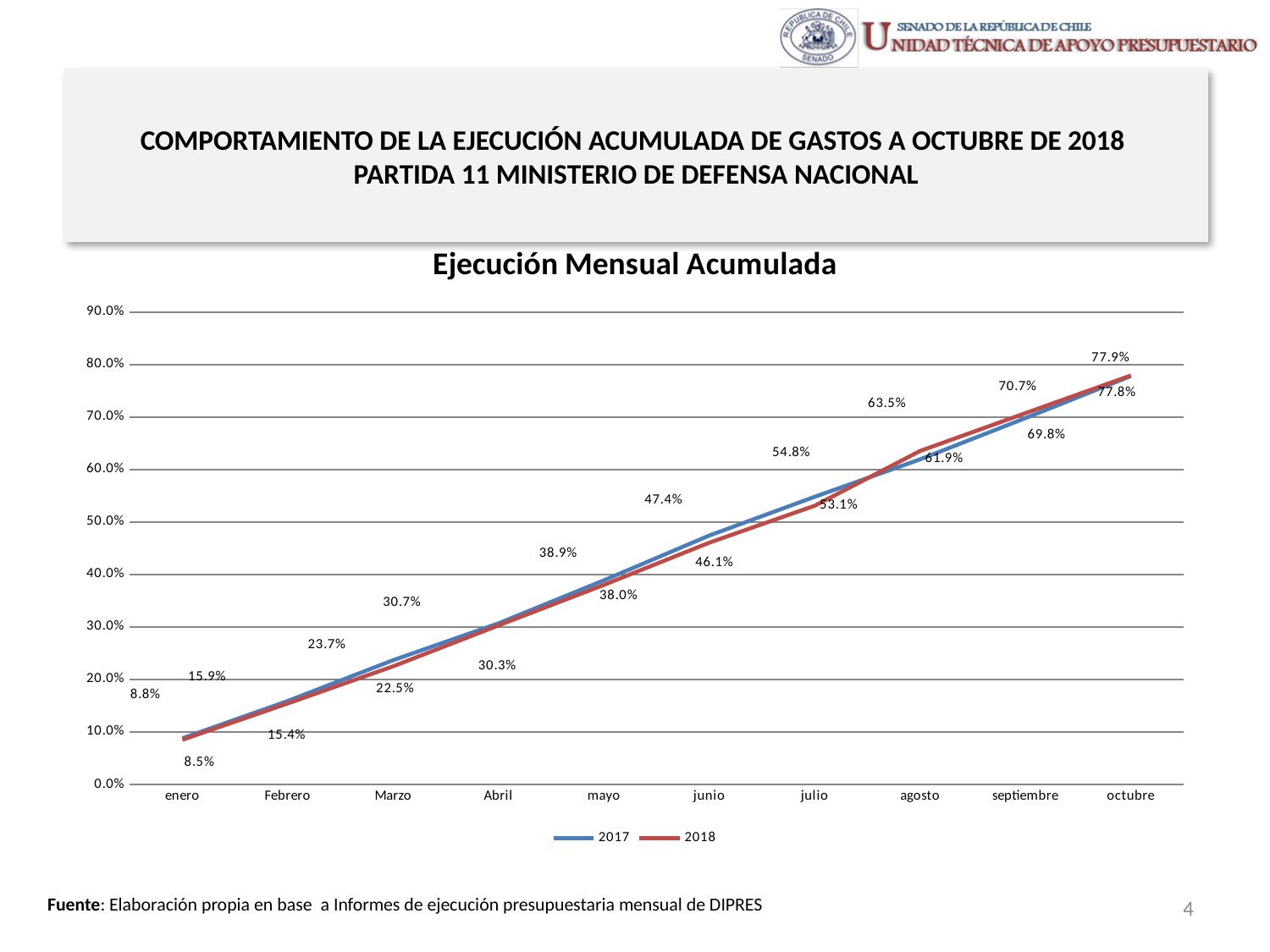
Which series has the larger value in julio, 2017 or 2018? 2017 Do the values of the 2017 series rise or fall from enero to octubre? Rise What is the value for 2018 in Marzo? 22.5% What is the difference between the 2017 and 2018 values in Marzo? 1.2 percentage points What kind of chart is shown on the slide? Line chart How many months are plotted along the x axis of the chart? 10 Is the value for 2018 in Abril greater or less than 40%? less How many series does the legend of the chart list? 2 What is the value for 2017 in julio? 54.8% What is the title of the chart? Ejecución Mensual Acumulada What is the value for 2018 in julio? 53.1% What is the value for 2017 in Marzo? 23.7%